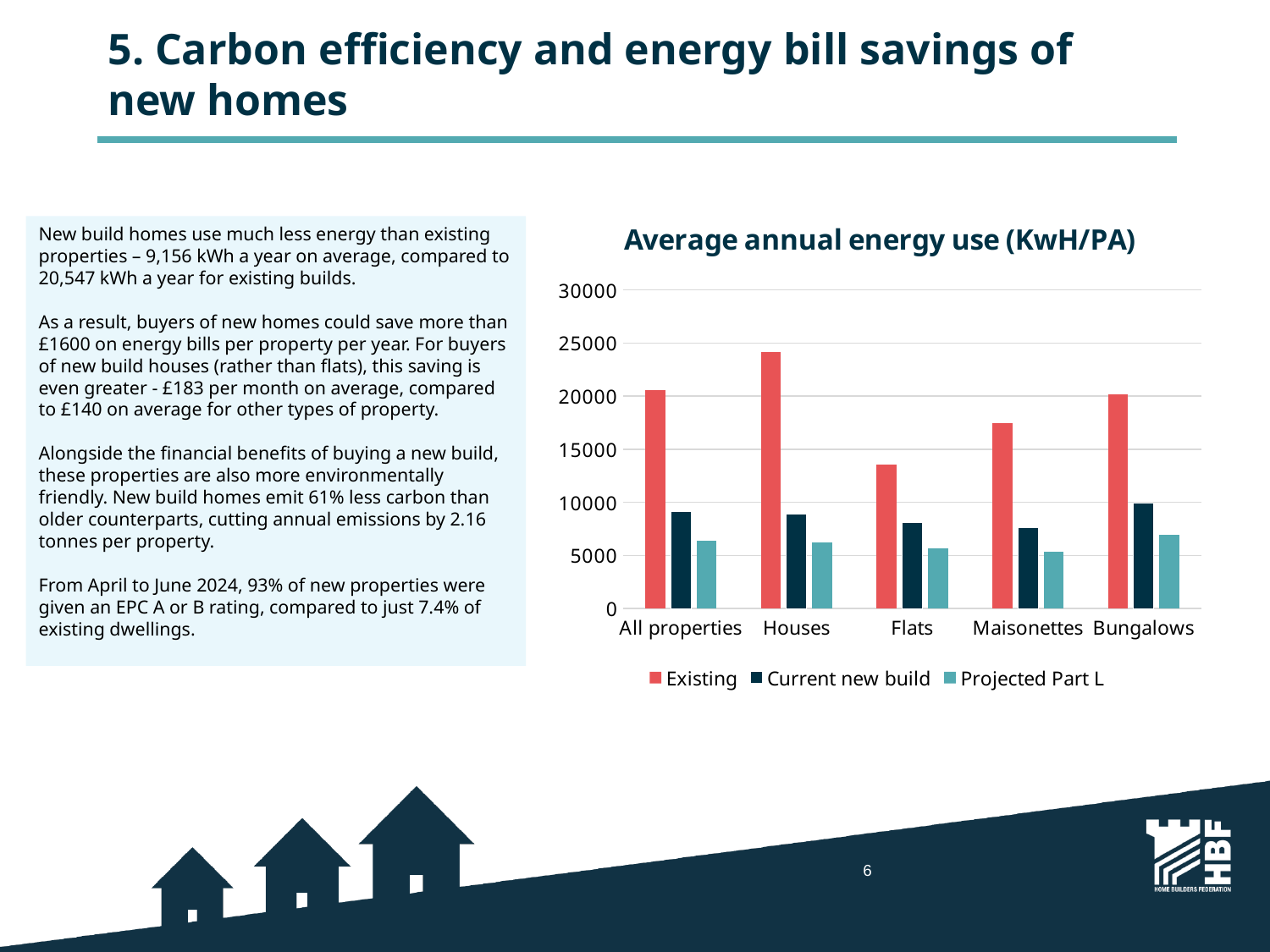
How many property categories are shown on the x axis of the chart? 5 Which category has the highest value for the Existing series? Houses Which category has the highest value for the Projected Part L series? Bungalows What type of chart is shown on the slide? bar chart What is the title of the chart? Average annual energy use (KwH/PA) Is the Current new build value for All properties greater or less than 10000? less Which category has the highest value for the Current new build series? Bungalows Which is larger for the Existing series: Maisonettes or Flats? Maisonettes Is the Existing value for Flats greater or less than 15000? less Is the Existing value for Houses greater or less than 20000? greater How many series does the chart legend list? 3 Which category has the lowest value for the Existing series? Flats